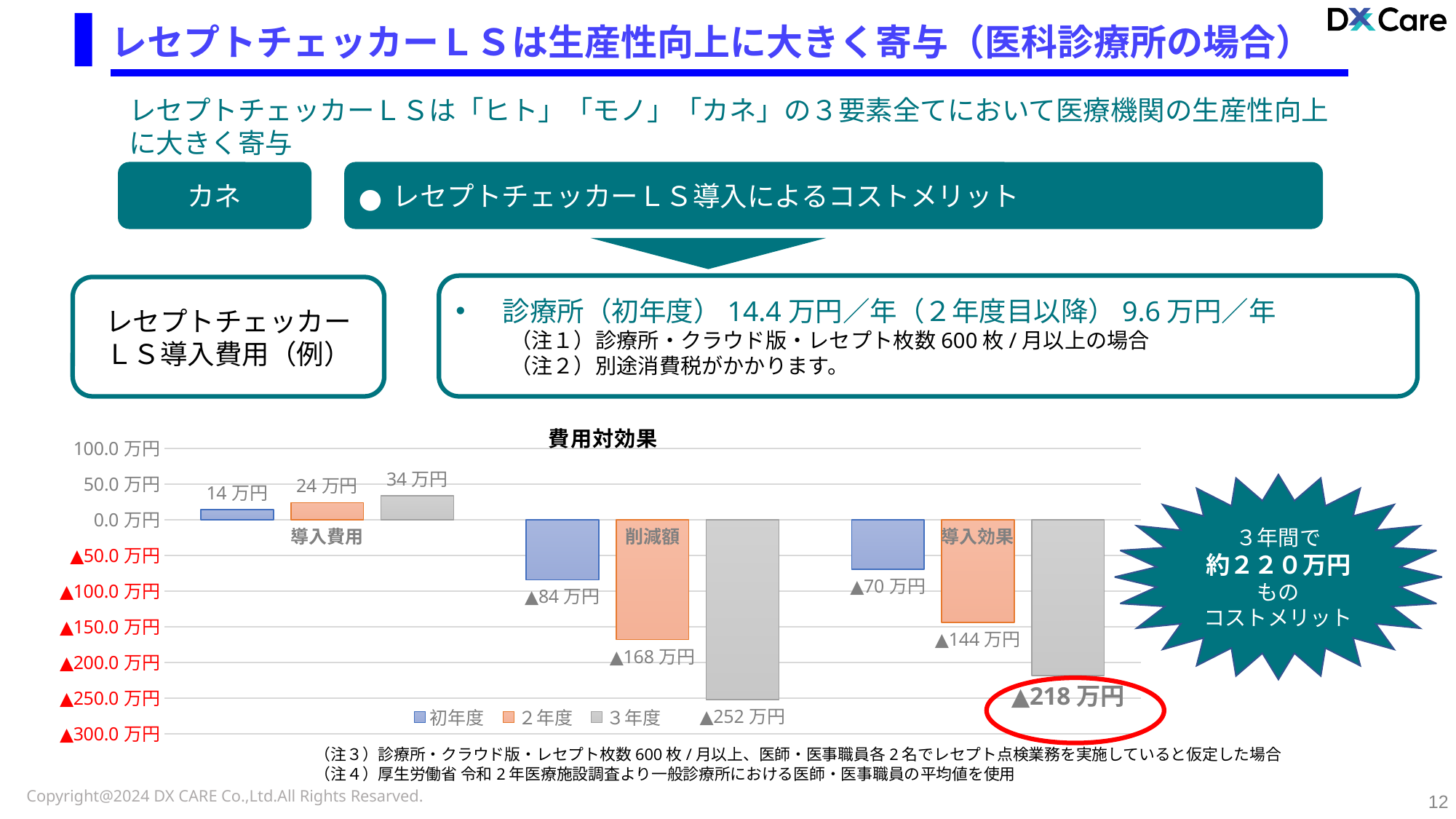
In the 費用対効果 chart, how many series does the legend list? 3 In the 費用対効果 chart, what is the 削減額 value for 2年度? ▲168 万円 In the 費用対効果 chart, what is the 導入効果 value for 3年度? ▲218 万円 In the 費用対効果 chart, what is the 導入費用 value for 3年度? 34 万円 What kind of chart is the 費用対効果 chart? bar chart In the 費用対効果 chart, which colour represents 2年度 in the legend? orange In the 費用対効果 chart, do the 導入費用 values rise or fall from 初年度 to 3年度? rise In the 費用対効果 chart, what is the 導入効果 value for 初年度? ▲70 万円 In the 費用対効果 chart, how many category groups are shown on the x axis? 3 In the 費用対効果 chart, what is the difference between the 導入費用 for 2年度 and 初年度? 10 万円 In the 費用対効果 chart, which year has the highest 導入費用? 3年度 In the 費用対効果 chart, what is the 導入費用 value for 初年度? 14 万円